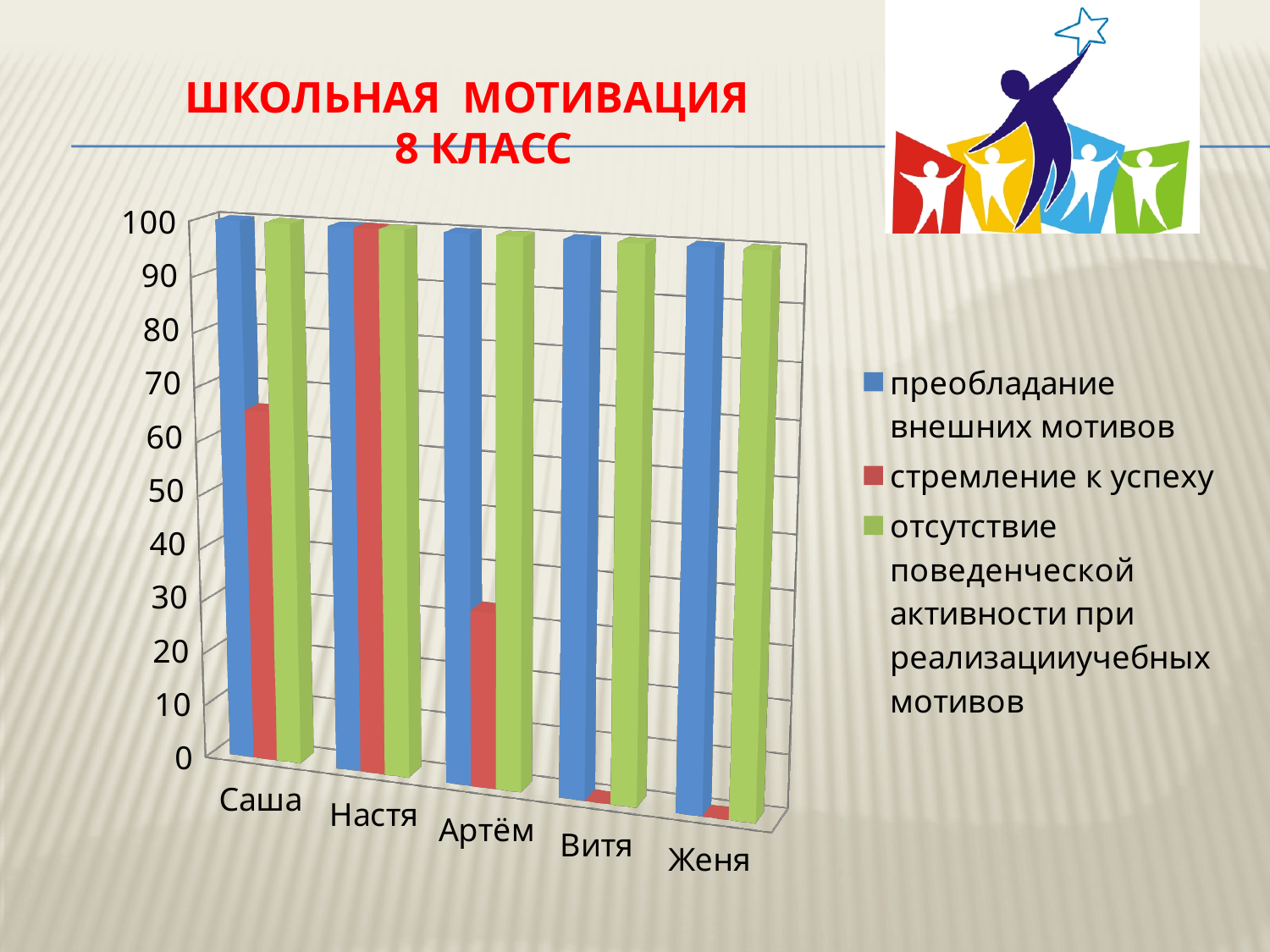
Which series is shown in green in the chart's legend? отсутствие поведенческой активности при реализацииучебных мотивов Which colour represents the series 'стремление к успеху' in the chart? red Which is larger: the 'стремление к успеху' value for Саша or for Артём? Саша Is the value of 'стремление к успеху' for Витя greater or less than 10? less How many students (categories) are shown on the x axis of the chart? 5 Is the value of 'стремление к успеху' for Саша greater or less than 60? greater What kind of chart is shown on the slide? bar chart Is the value of 'преобладание внешних мотивов' for Женя greater or less than 90? greater How many series does the chart's legend list? 3 Which student has the highest value for the series 'стремление к успеху'? Настя